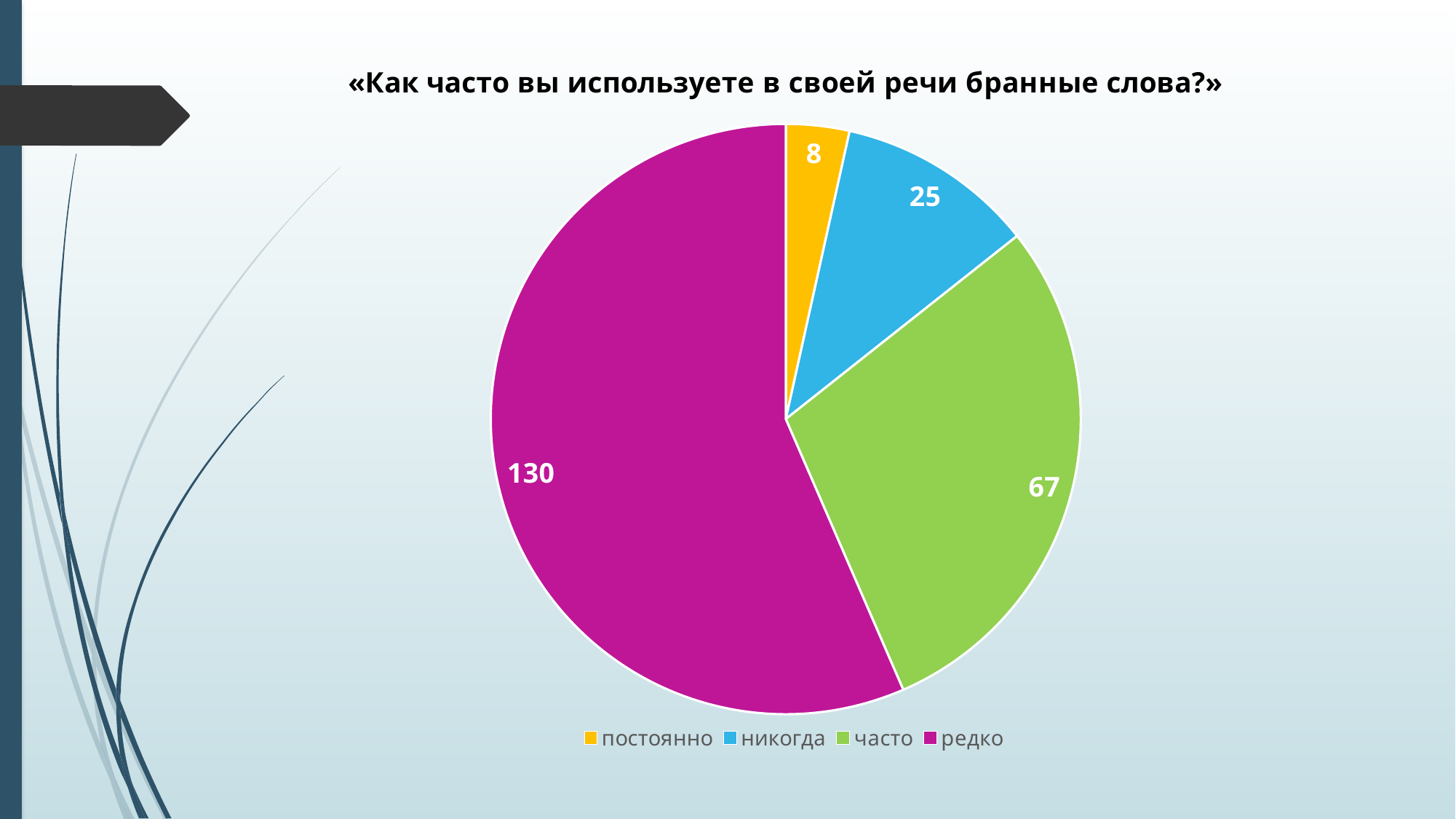
What is the title of the chart? «Как часто вы используете в своей речи бранные слова?» What is the value for «постоянно»? 8 How many categories does the pie chart have? 4 Which category has the largest slice? редко What is the value for «часто»? 67 What is the total of all slices in the pie chart? 230 What is the difference between the values for «редко» and «часто»? 63 What is the value for «редко»? 130 What is the value for «никогда»? 25 Which is larger, the value for «никогда» or the value for «часто»? часто What kind of chart is shown on the slide? pie chart Which category has the smallest slice? постоянно